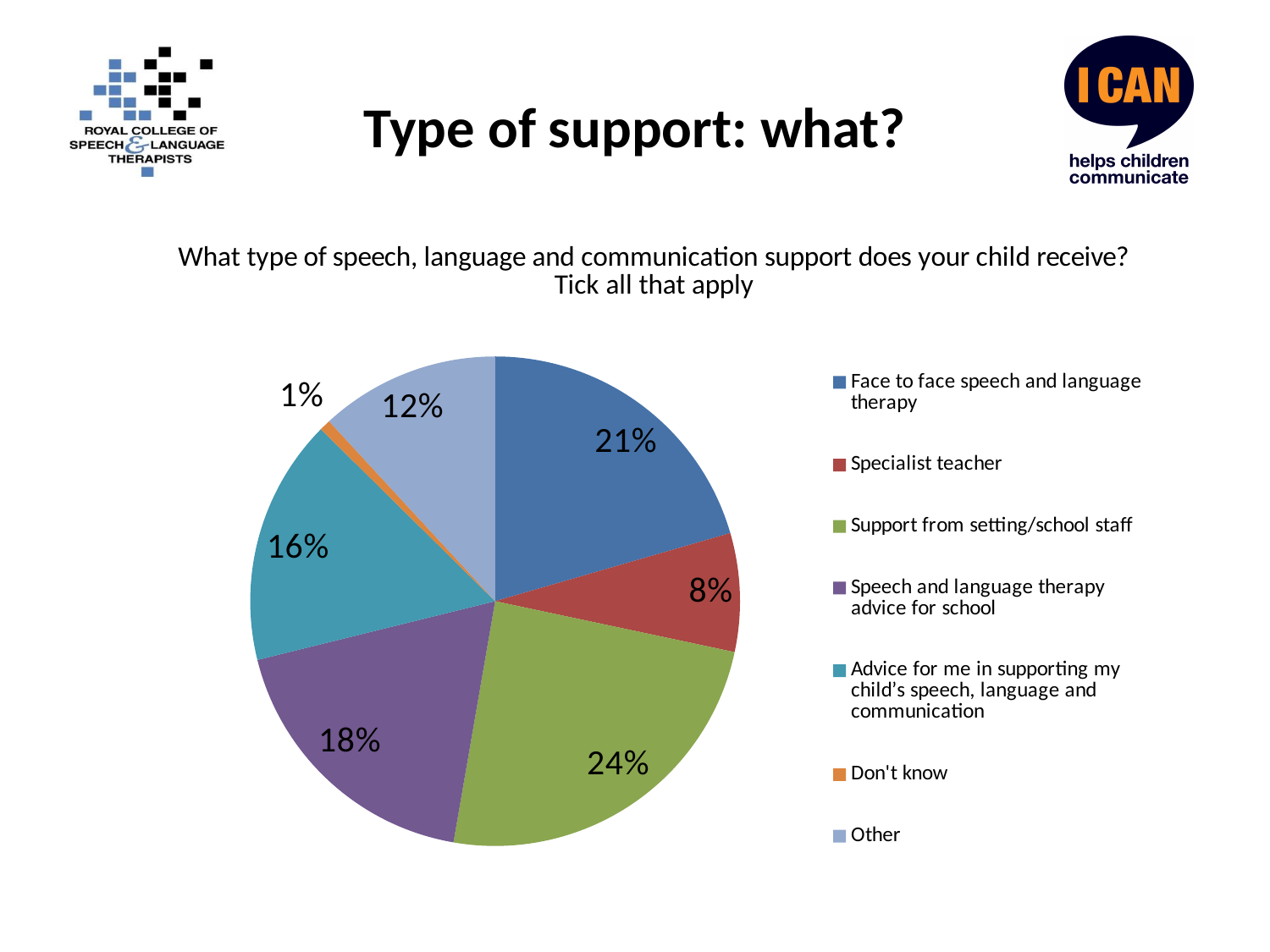
Which category has the smallest slice of the pie? Don't know What share of the pie is 'Don't know'? 1% What is the difference in percentage points between 'Support from setting/school staff' and 'Specialist teacher'? 16 How many categories does the legend list? 7 What kind of chart is shown on the slide? pie chart Which category has the largest slice of the pie? Support from setting/school staff Which is larger: 'Advice for me in supporting my child's speech, language and communication' or 'Other'? Advice for me in supporting my child's speech, language and communication What share of the pie is 'Support from setting/school staff'? 24% What is the title of the slide? Type of support: what? What share of the pie is 'Face to face speech and language therapy'? 21%